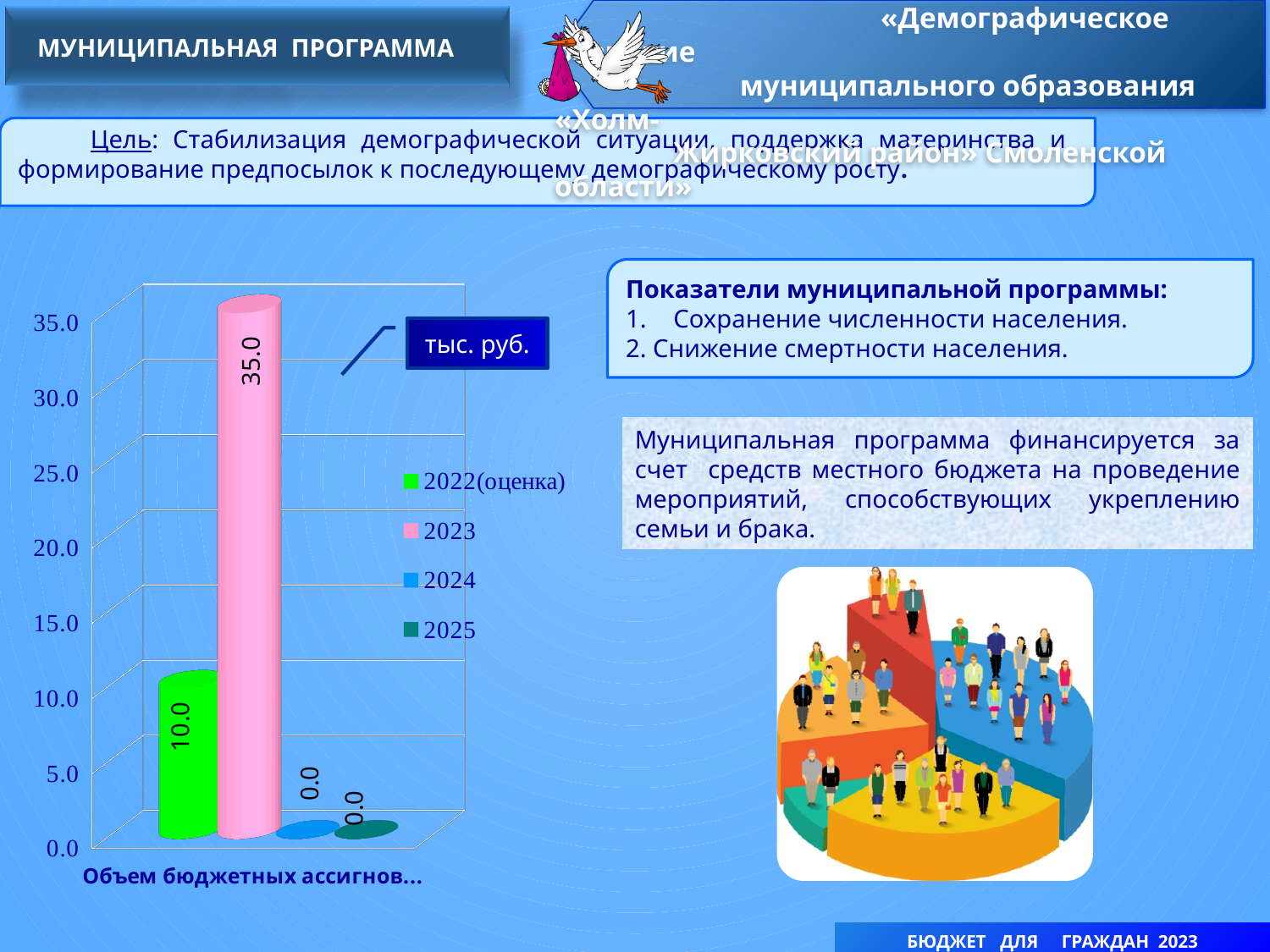
Which is larger, the value for 2022(оценка) or the value for 2023? 2023 What is the difference between the values for 2023 and 2022(оценка)? 25.0 What is the value for 2022(оценка) on the chart? 10.0 How many series does the chart legend list? 4 What is the value for 2024 on the chart? 0.0 Is the value for 2023 greater or less than 30.0? greater What is the value for 2023 on the chart? 35.0 What is the value for 2025 on the chart? 0.0 Which year has the highest value on the chart? 2023 What unit is indicated in the callout box next to the chart? тыс. руб. What colour is the bar for 2023 in the chart? pink What kind of chart is shown on the slide? bar chart